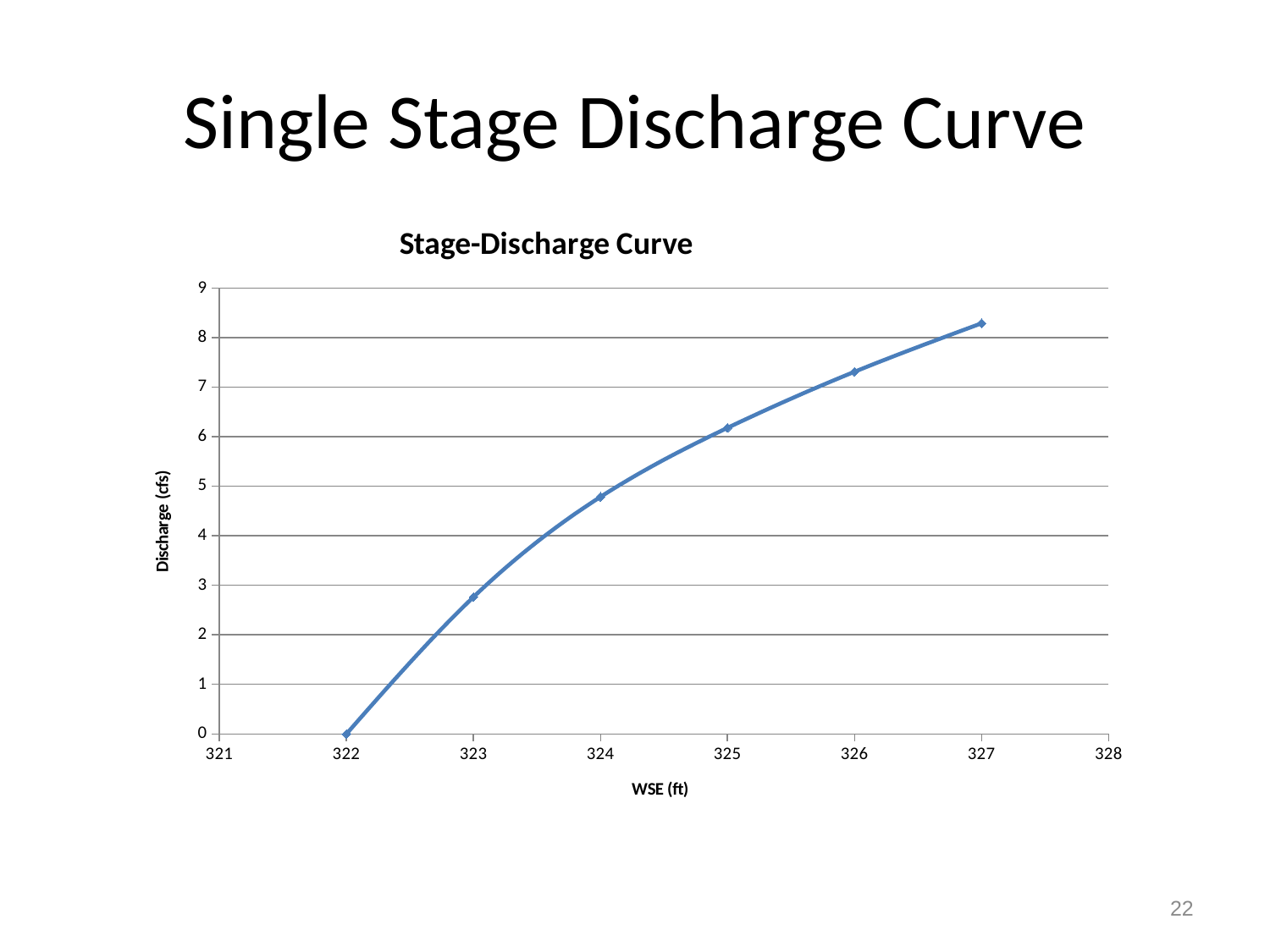
What is the discharge value at a WSE of 322 ft? 0 At which WSE value is the discharge lowest? 322 Is the discharge at a WSE of 323 ft greater or less than 2? greater At which WSE value is the discharge highest? 327 What kind of chart is shown on the slide? line chart What is the title of the chart? Stage-Discharge Curve Which has the larger discharge, a WSE of 324 ft or a WSE of 326 ft? 326 Is the discharge at a WSE of 327 ft greater or less than 8? greater Is the discharge at a WSE of 324 ft greater or less than 4? greater How many data points are plotted on the curve? 6 What is the label of the vertical axis? Discharge (cfs) Does the discharge rise or fall as WSE increases along the x axis? rise